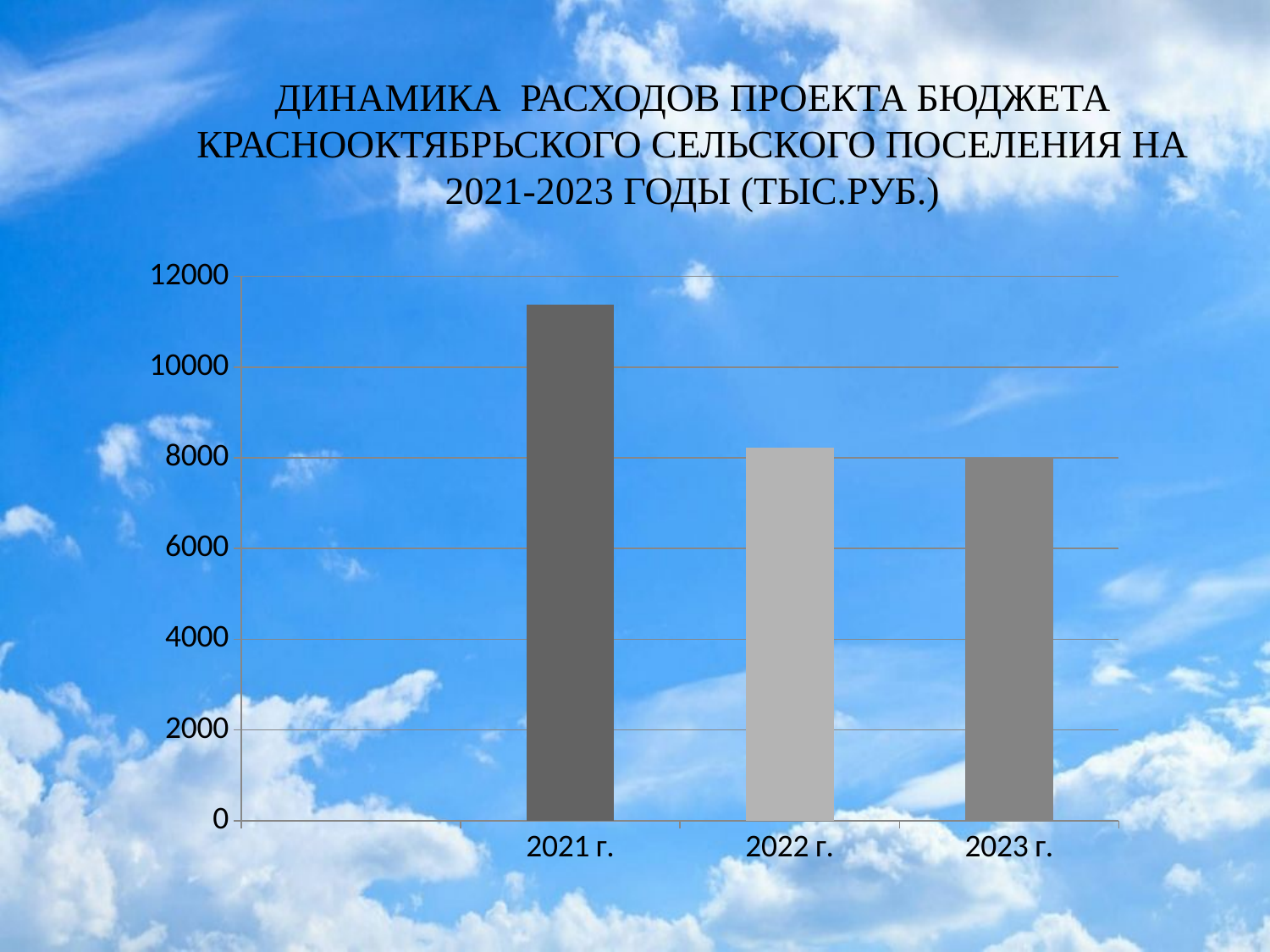
Do the values rise or fall from 2021 г. to 2023 г.? fall Is the value for 2022 г. greater or less than 10000? less Is the value for 2021 г. greater or less than 10000? greater Which is larger, the value for 2021 г. or the value for 2023 г.? 2021 г. In what units are the values on the chart expressed, according to the title? тыс.руб. Is the value for 2023 г. greater or less than 10000? less How many years (categories) are plotted on the chart? 3 What kind of chart is shown on the slide? Bar chart Which year has the highest expenditure value on the chart? 2021 г.